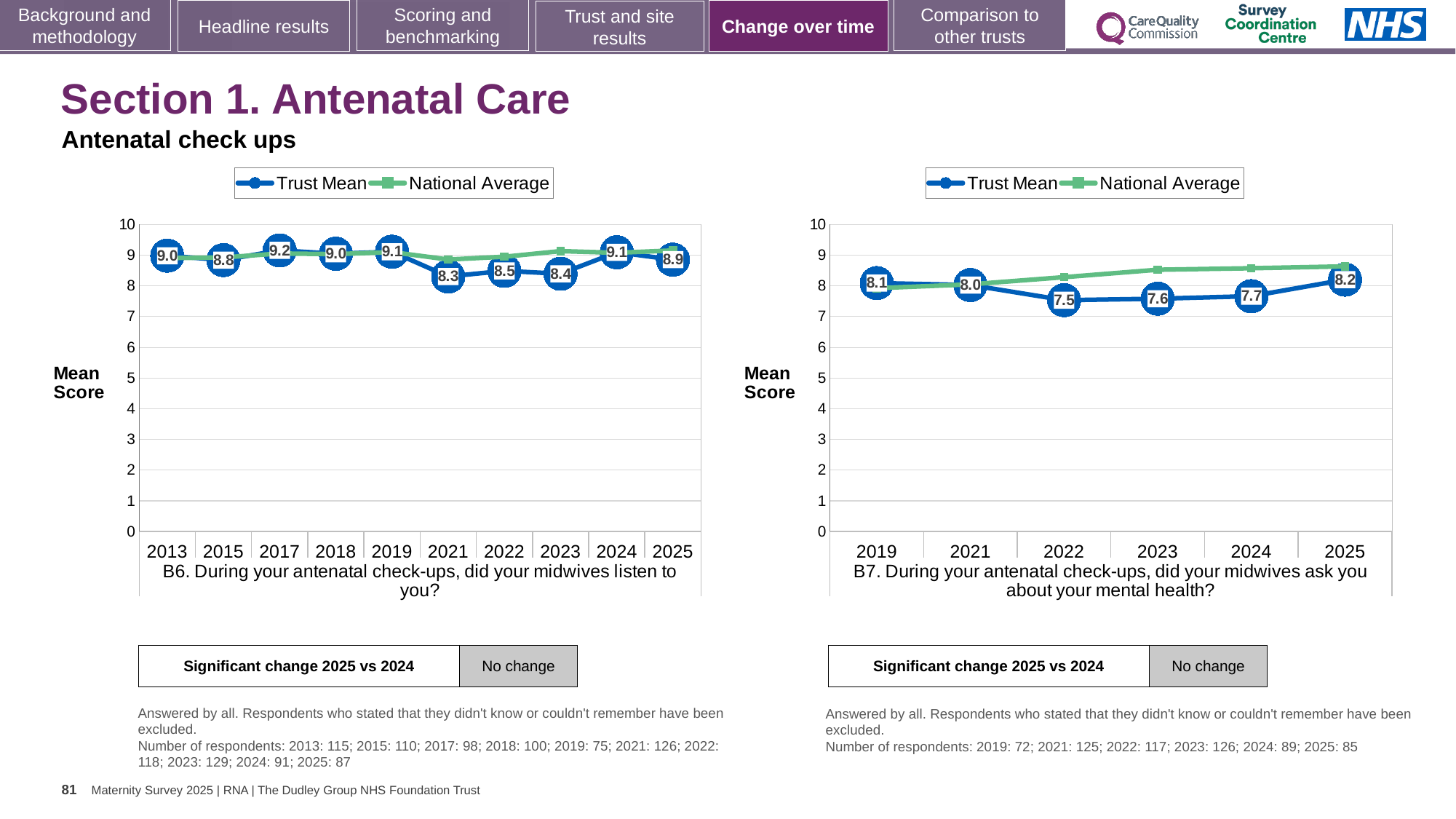
In the B7 chart (right), what is the Trust Mean for 2022? 7.5 In the B7 chart (right), what is the difference between the Trust Mean for 2025 and 2022? 0.7 In the B7 chart (right), how many series does the legend list? 2 In the B7 chart (right), is the Trust Mean for 2023 greater or less than 8? less In the B6 chart (left), which year has the highest Trust Mean? 2017 In the B6 chart (left), how many years are shown on the x axis? 10 In the B6 chart (left), what is the difference between the Trust Mean for 2024 and 2025? 0.2 What kind of chart is the B7 chart (right)? Line chart In the B6 chart (left), what is the Trust Mean for 2017? 9.2 In the B6 chart (left), what is the Trust Mean for 2021? 8.3 In the B6 chart (left), which year has the lowest Trust Mean? 2021 In the B7 chart (right), which year has the highest Trust Mean? 2025